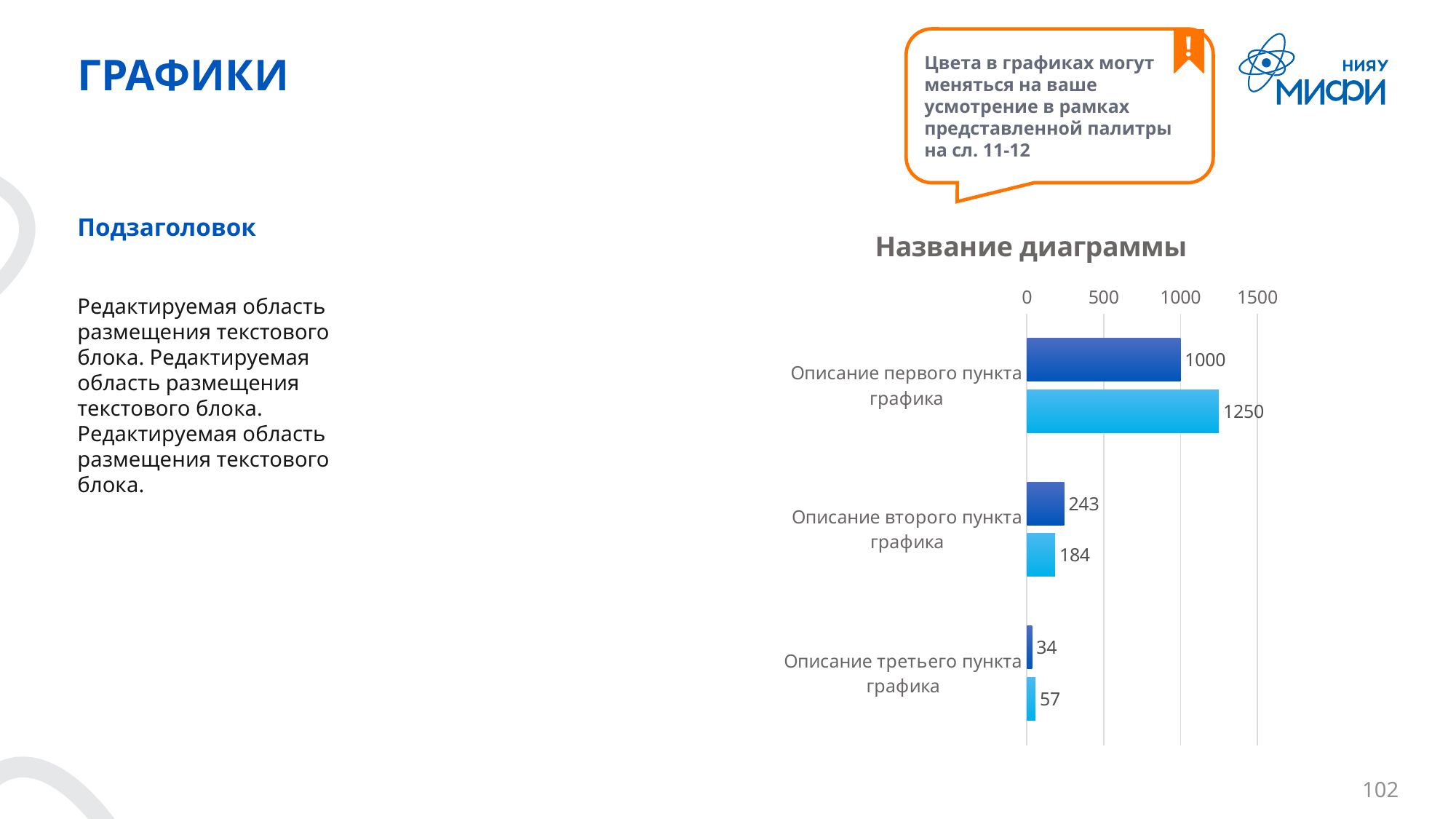
What is the value of the light blue bar for "Описание первого пункта графика"? 1250 For "Описание второго пункта графика", which bar is larger, the dark blue or the light blue? dark blue Which category has the highest light blue bar? Описание первого пункта графика How many categories are shown on the chart? 3 What is the difference between the light blue and dark blue bars for "Описание первого пункта графика"? 250 What kind of chart is shown on the slide? bar chart What is the value of the dark blue bar for "Описание первого пункта графика"? 1000 What is the total of the two bars for "Описание второго пункта графика"? 427 What is the value of the light blue bar for "Описание третьего пункта графика"? 57 Which category has the lowest dark blue bar? Описание третьего пункта графика What is the title of the chart? Название диаграммы What is the value of the dark blue bar for "Описание второго пункта графика"? 243